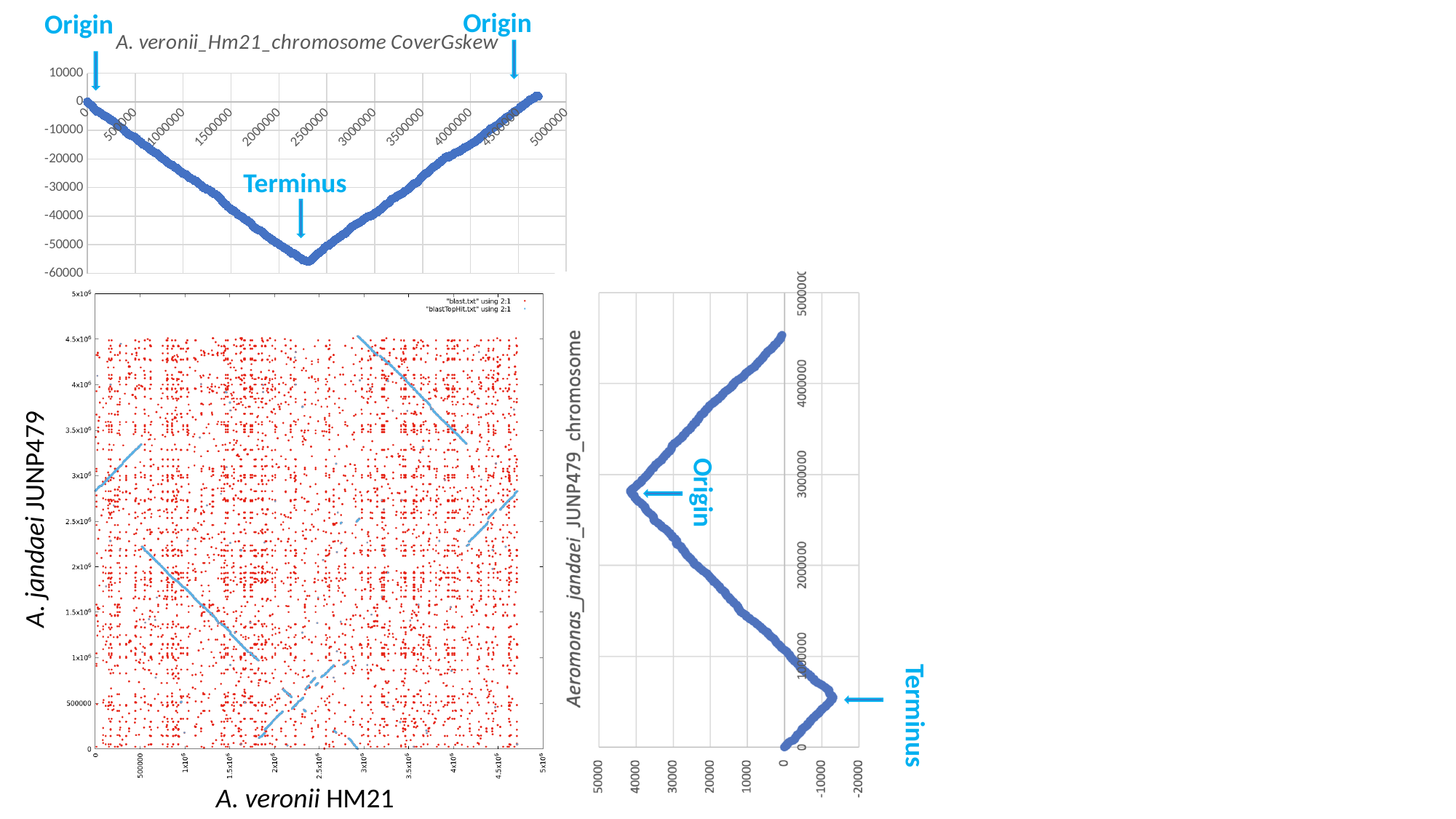
In the bottom-left dot plot, how many series does the legend list? 2 In the right-hand chart (Aeromonas_jandaei_JUNP479_chromosome), which labelled point has the larger value, Origin or Terminus? Origin In the right-hand chart (Aeromonas_jandaei_JUNP479_chromosome), is the value at the point labelled Terminus greater or less than 0? less What is the title of the chart at the top left of the slide? A. veronii_Hm21_chromosome CoverGskew In the top-left chart (A. veronii_Hm21_chromosome CoverGskew), which labelled point marks the lowest value of the curve: Origin or Terminus? Terminus In the right-hand chart (Aeromonas_jandaei_JUNP479_chromosome), is the value at the point labelled Origin greater or less than 30000? greater In the bottom-left dot plot, what is the label on the x axis? A. veronii HM21 In the top-left chart (A. veronii_Hm21_chromosome CoverGskew), what is the highest value shown on the y axis? 10000 In the top-left chart (A. veronii_Hm21_chromosome CoverGskew), do the values rise or fall along the x axis between 0 and 2000000? fall In the top-left chart (A. veronii_Hm21_chromosome CoverGskew), is the lowest plotted value greater or less than -50000? less In the top-left chart (A. veronii_Hm21_chromosome CoverGskew), what kind of chart is shown? scatter chart In the top-left chart (A. veronii_Hm21_chromosome CoverGskew), do the values rise or fall along the x axis between 3000000 and 4500000? rise